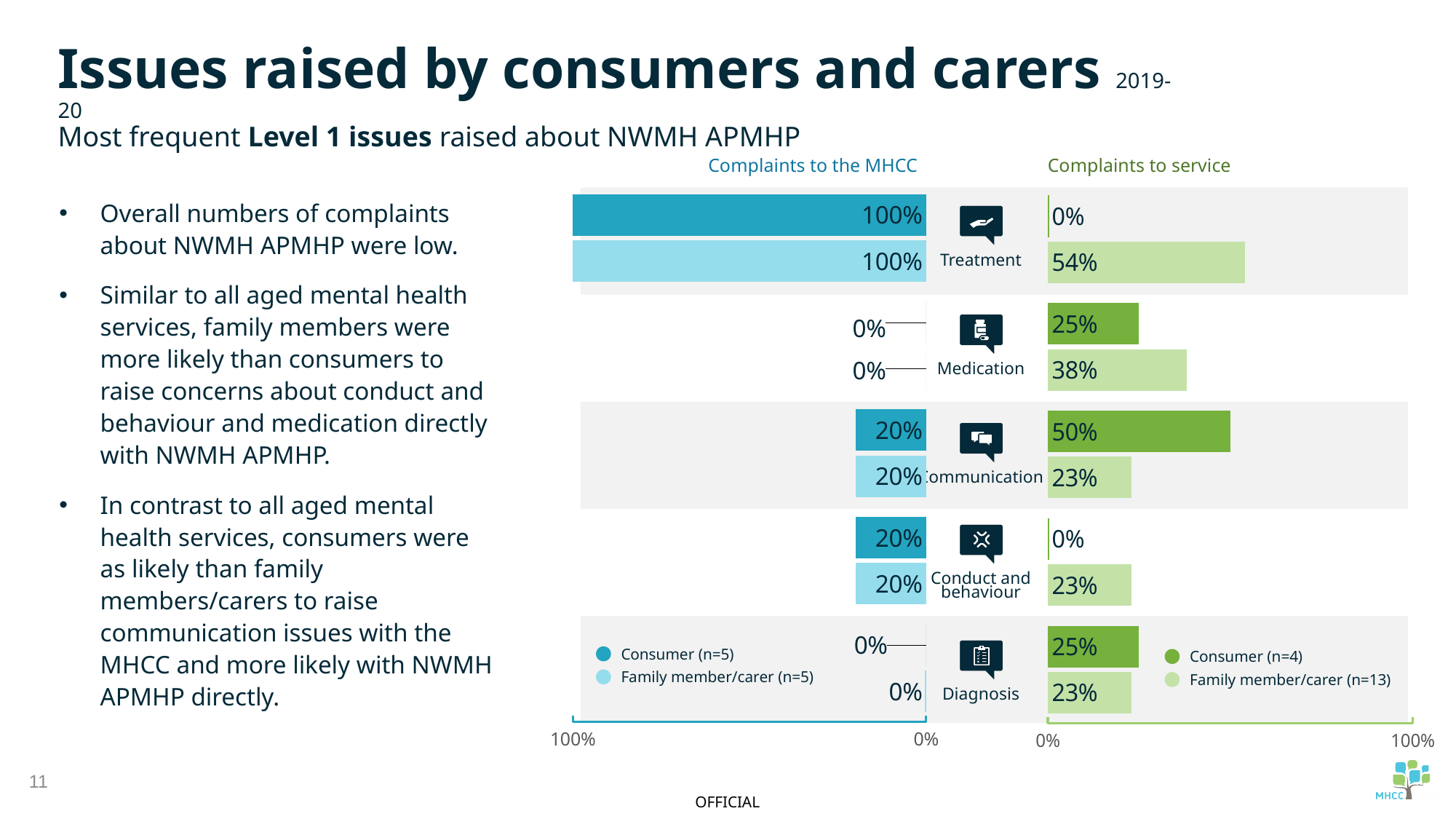
How many series does the legend of the 'Complaints to service' chart list? 2 In the 'Complaints to service' chart, what sample size is shown for Family member/carer in the legend? n=13 In the 'Complaints to service' chart, what is the Consumer value for Medication? 25% In the 'Complaints to service' chart, what is the difference between the Family member/carer and Consumer values for Medication? 13% What kind of chart is the 'Complaints to the MHCC' chart? Bar chart In the 'Complaints to the MHCC' chart, what is the Consumer value for Treatment? 100% How many categories are shown in the 'Complaints to the MHCC' chart? 5 In the 'Complaints to service' chart, what is the value for Family member/carer for Treatment? 54% In the 'Complaints to service' chart, which category has the highest Consumer value? Communication In the 'Complaints to service' chart, which is larger for Communication: the Consumer value or the Family member/carer value? Consumer In the 'Complaints to service' chart, which category has the highest Family member/carer value? Treatment In the 'Complaints to service' chart, what is the Consumer value for Communication? 50%